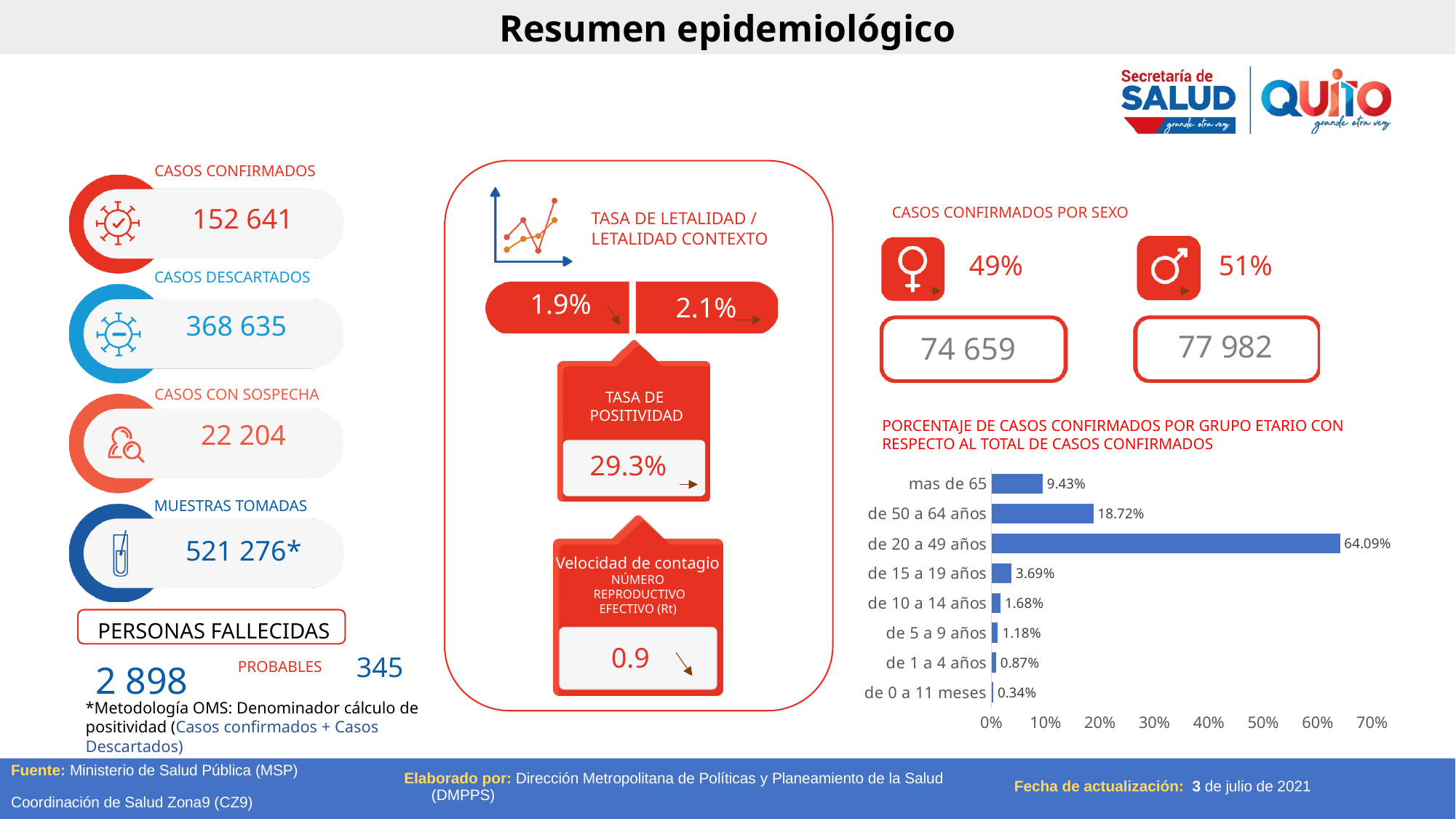
What is the difference in percentage points between the 'de 50 a 64 años' and 'mas de 65' age groups in the chart? 9.29 What type of chart is used to show the percentage of confirmed cases by age group? Bar chart Which age group has the highest percentage of confirmed cases in the chart? de 20 a 49 años How many age groups are shown in the bar chart? 8 What percentage of confirmed cases does the chart show for the 'de 50 a 64 años' age group? 18.72% What percentage of confirmed cases does the chart show for the 'de 0 a 11 meses' age group? 0.34% Which age group has a larger share of confirmed cases in the chart: 'de 15 a 19 años' or 'de 10 a 14 años'? de 15 a 19 años What percentage of confirmed cases does the chart show for the 'mas de 65' age group? 9.43% What is the highest value shown on the horizontal axis of the age group chart? 70% Is the value for 'de 20 a 49 años' in the chart greater or less than 60%? greater Which age group has the lowest percentage of confirmed cases in the chart? de 0 a 11 meses What percentage of confirmed cases does the chart show for the 'de 20 a 49 años' age group? 64.09%